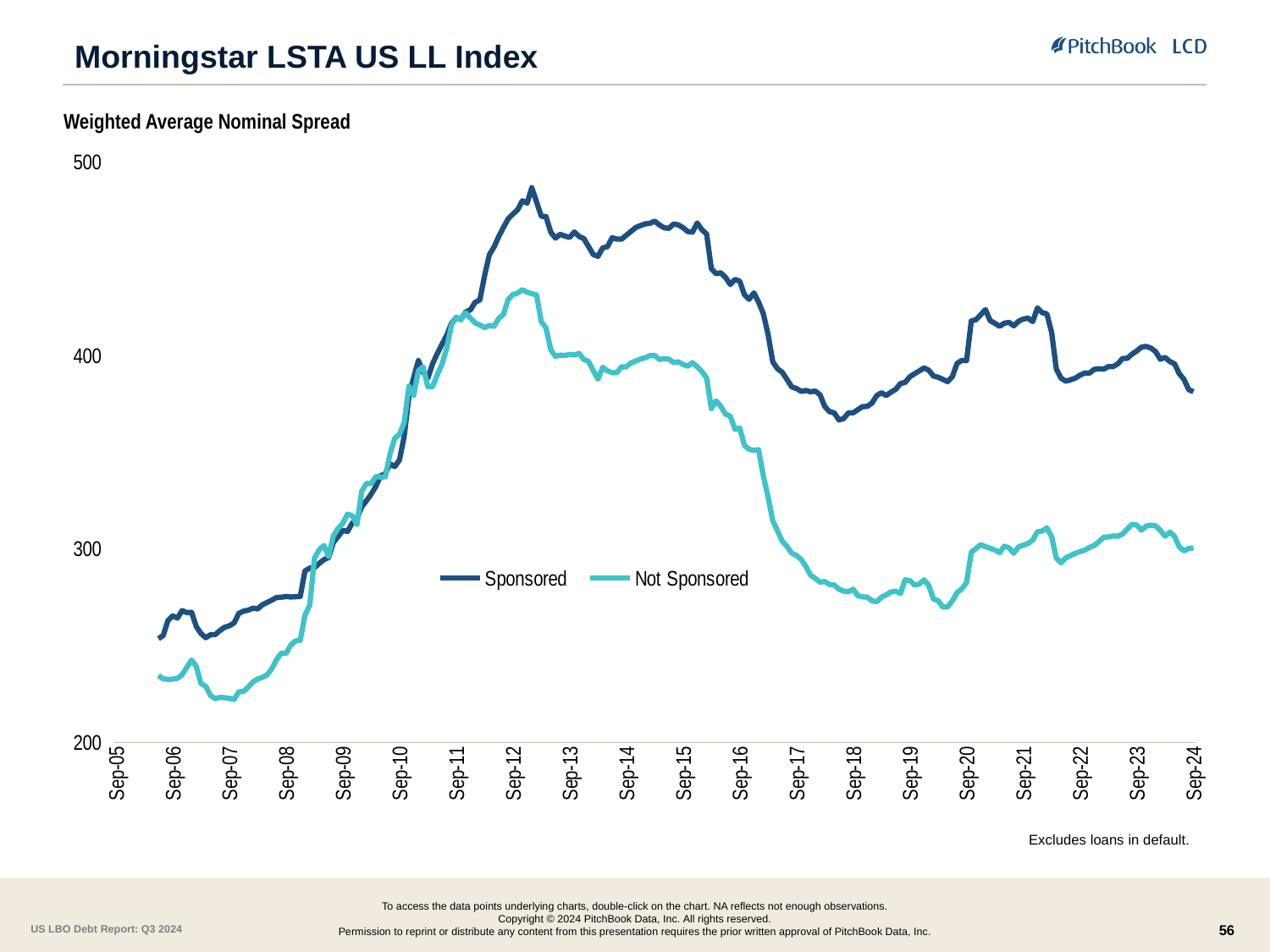
How many year labels are shown on the x axis, from Sep-05 to Sep-24? 20 Is the value for Sponsored at Sep-24 greater or less than 400? less Which series reaches the highest value anywhere on the chart? Sponsored Is the value for Not Sponsored at Sep-18 greater or less than 300? less Is the value for Not Sponsored at Sep-07 greater or less than 300? less At Sep-20, which series has the higher value, Sponsored or Not Sponsored? Sponsored What are the two series named in the legend? Sponsored and Not Sponsored What kind of chart is shown on the slide? Line chart What is the title of the chart? Weighted Average Nominal Spread How many series does the legend list? 2 Does the Sponsored series rise or fall between Sep-12 and Sep-18? Fall